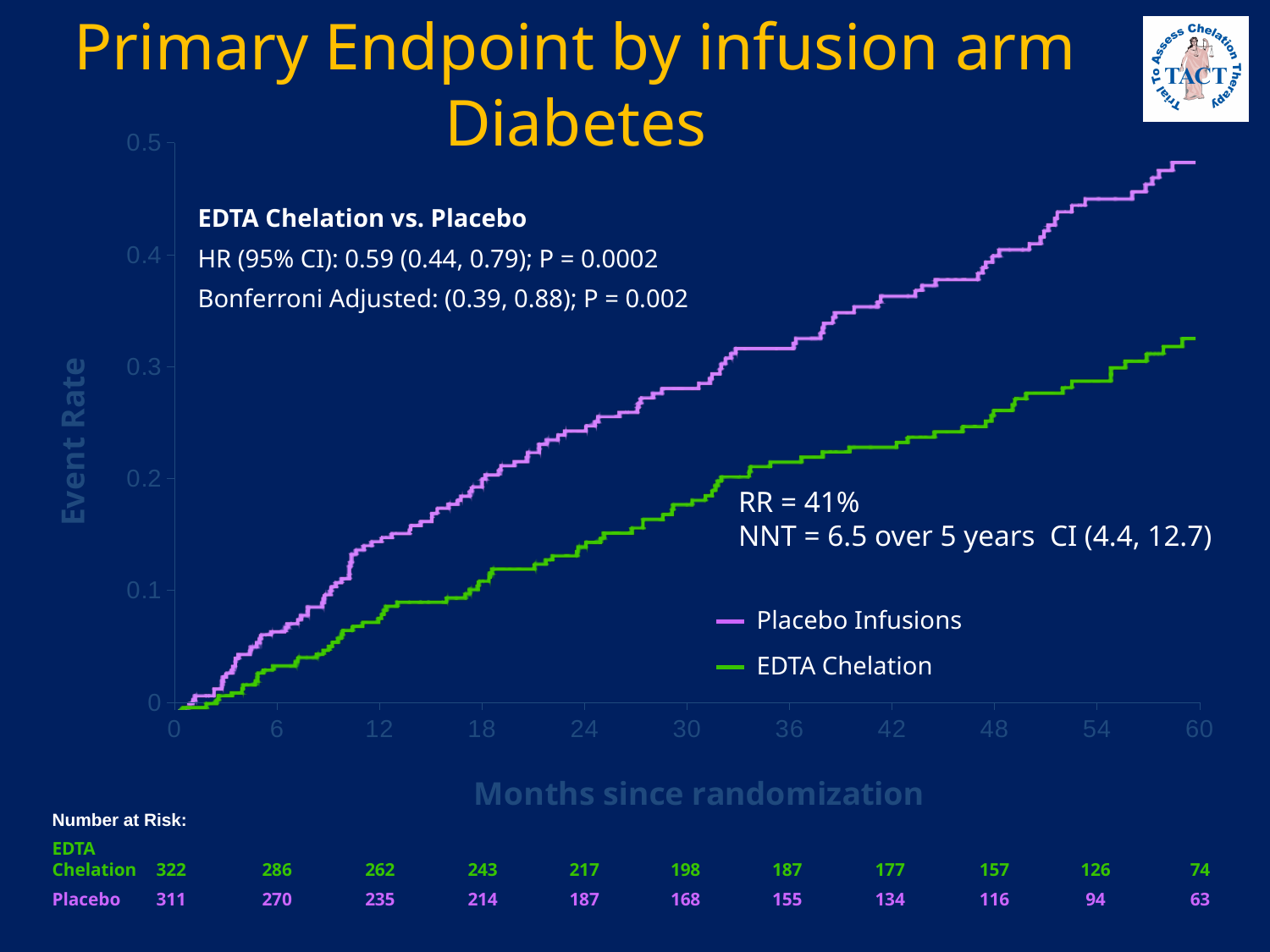
At 60 months, which series has the higher event rate, Placebo Infusions or EDTA Chelation? Placebo Infusions Which series is plotted in green? EDTA Chelation What kind of chart is shown on the slide? line chart Do the event rates rise or fall as months since randomization increase? rise What is the difference between the EDTA Chelation and Placebo numbers at risk at 0 months? 11 What hazard ratio is reported for EDTA Chelation vs. Placebo on the slide? 0.59 Is the event rate for EDTA Chelation at 24 months greater or less than 0.2? less In the Number at Risk table, how many EDTA Chelation patients were at risk at 0 months? 322 Is the event rate for Placebo Infusions at 60 months greater or less than 0.4? greater Is the event rate for EDTA Chelation at 60 months greater or less than 0.4? less How many series does the legend list? 2 In the Number at Risk table, how many Placebo patients were at risk at 60 months? 63